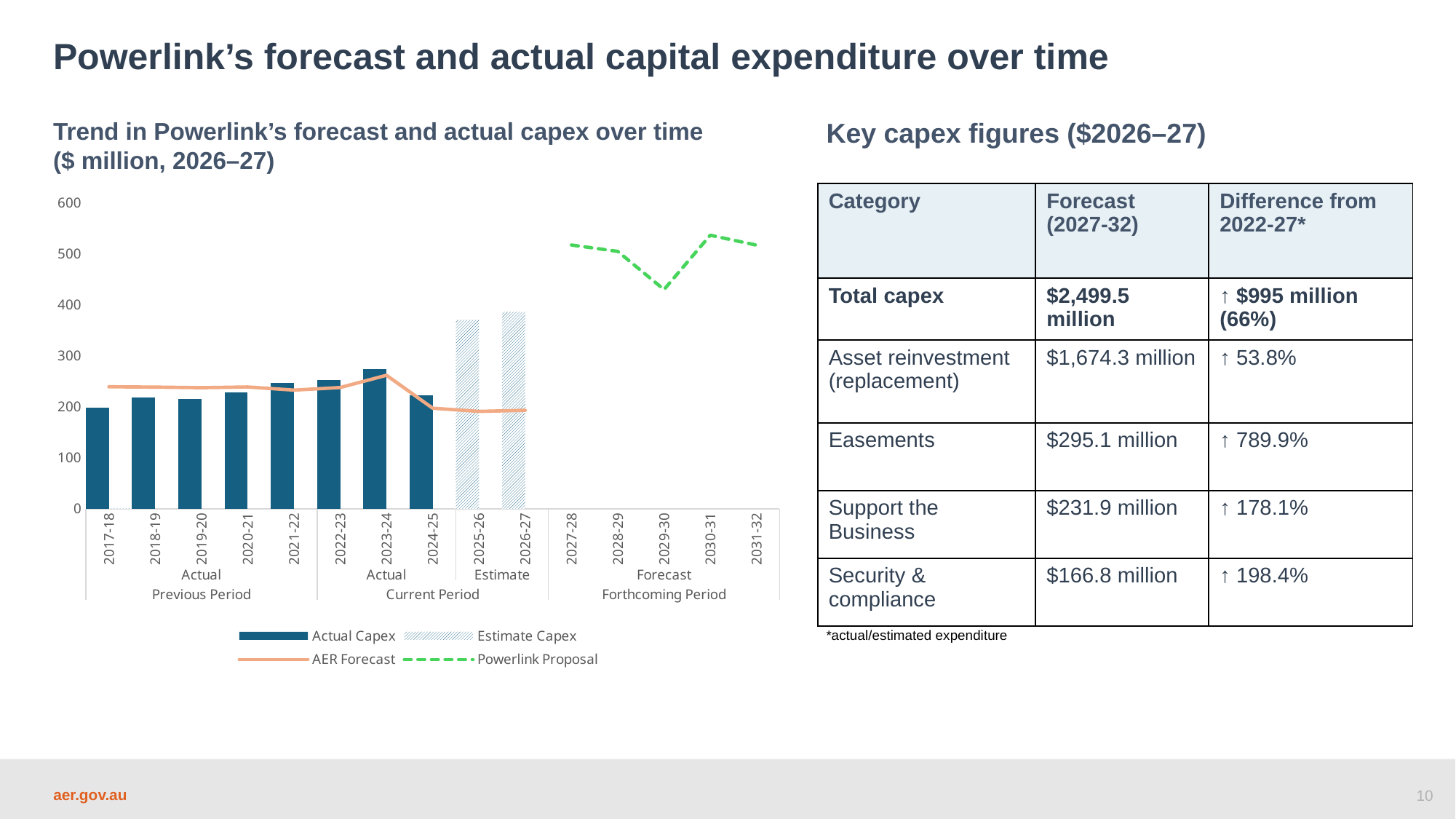
How many series does the chart legend list? 4 Is the Powerlink Proposal value for 2030-31 greater or less than 500? greater Is the Actual Capex value for 2017-18 greater or less than 300? less Do the Actual Capex bars generally rise or fall from 2017-18 to 2023-24? rise What kind of chart is shown on the slide? A bar chart combined with line series Which is larger: the Estimate Capex for 2026-27 or the Actual Capex for 2023-24? Estimate Capex for 2026-27 How many financial years are shown along the x axis of the chart? 15 Which year has the highest Actual Capex bar? 2023-24 Which year has the lowest Actual Capex bar? 2017-18 Is the Estimate Capex value for 2026-27 greater or less than 300? greater What are the three period labels shown beneath the x axis of the chart? Previous Period, Current Period, Forthcoming Period In which year is the Powerlink Proposal line at its lowest point? 2029-30